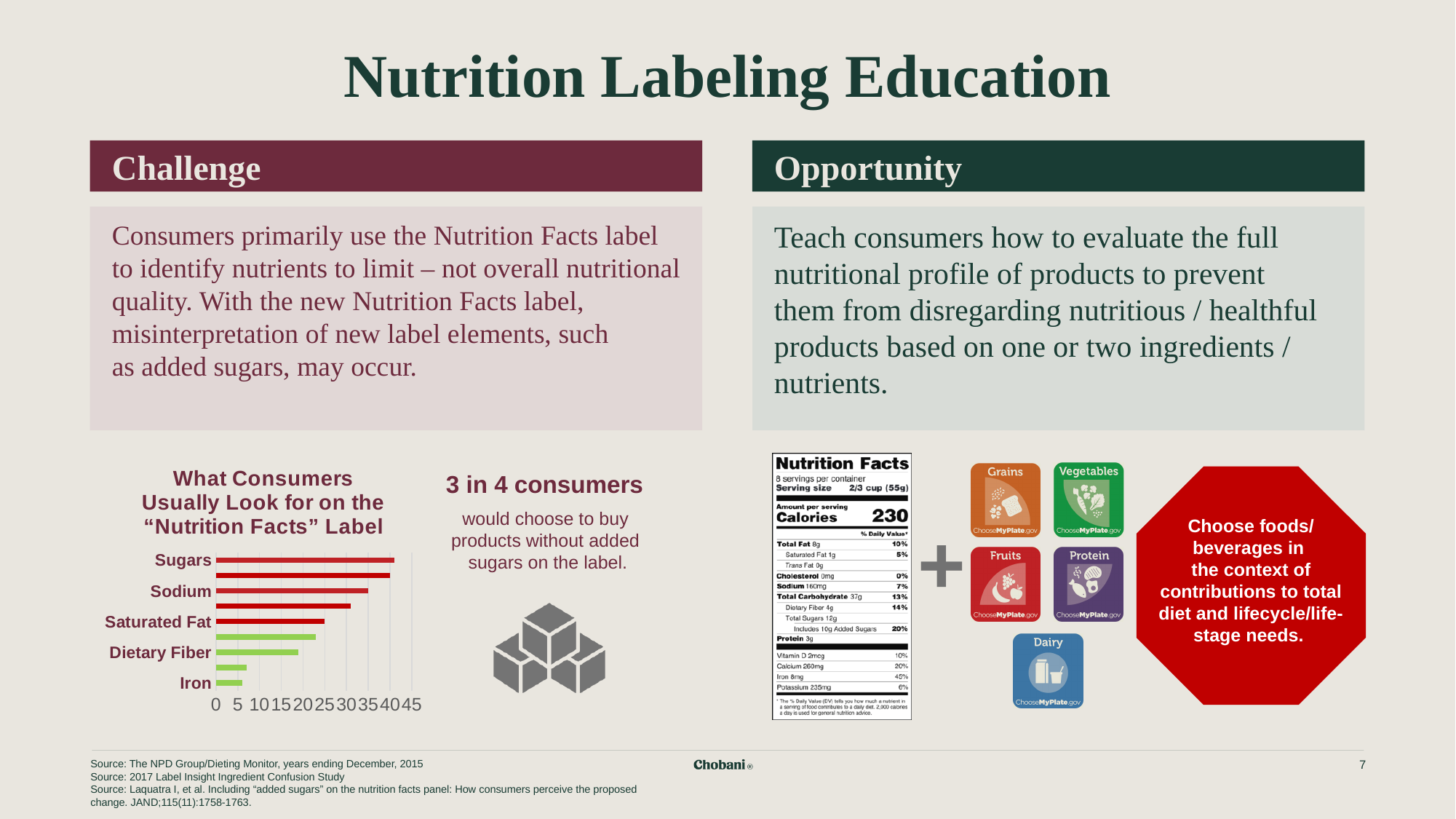
On the "What Consumers Usually Look for" chart, what colour are the bars for Dietary Fiber and Iron? green What is the highest tick value shown on the axis of the "What Consumers Usually Look for" chart? 45 On the "What Consumers Usually Look for" chart, are the bars for Saturated Fat greater or less than 30? less On the "What Consumers Usually Look for" chart, which is larger: the longer bar for Sodium or the longer bar for Saturated Fat? Sodium How many categories are shown on the "What Consumers Usually Look for on the “Nutrition Facts” Label" chart? 9 On the "What Consumers Usually Look for" chart, do the values rise or fall going down the categories from Sugars to Iron? fall On the "What Consumers Usually Look for" chart, are the bars for Iron greater or less than 10? less On the "What Consumers Usually Look for" chart, is the longer bar for Sodium greater or less than 30? greater Which category has the lowest values on the "What Consumers Usually Look for" chart? Iron What kind of chart is "What Consumers Usually Look for on the “Nutrition Facts” Label"? bar chart Which category has the highest values on the "What Consumers Usually Look for" chart? Sugars